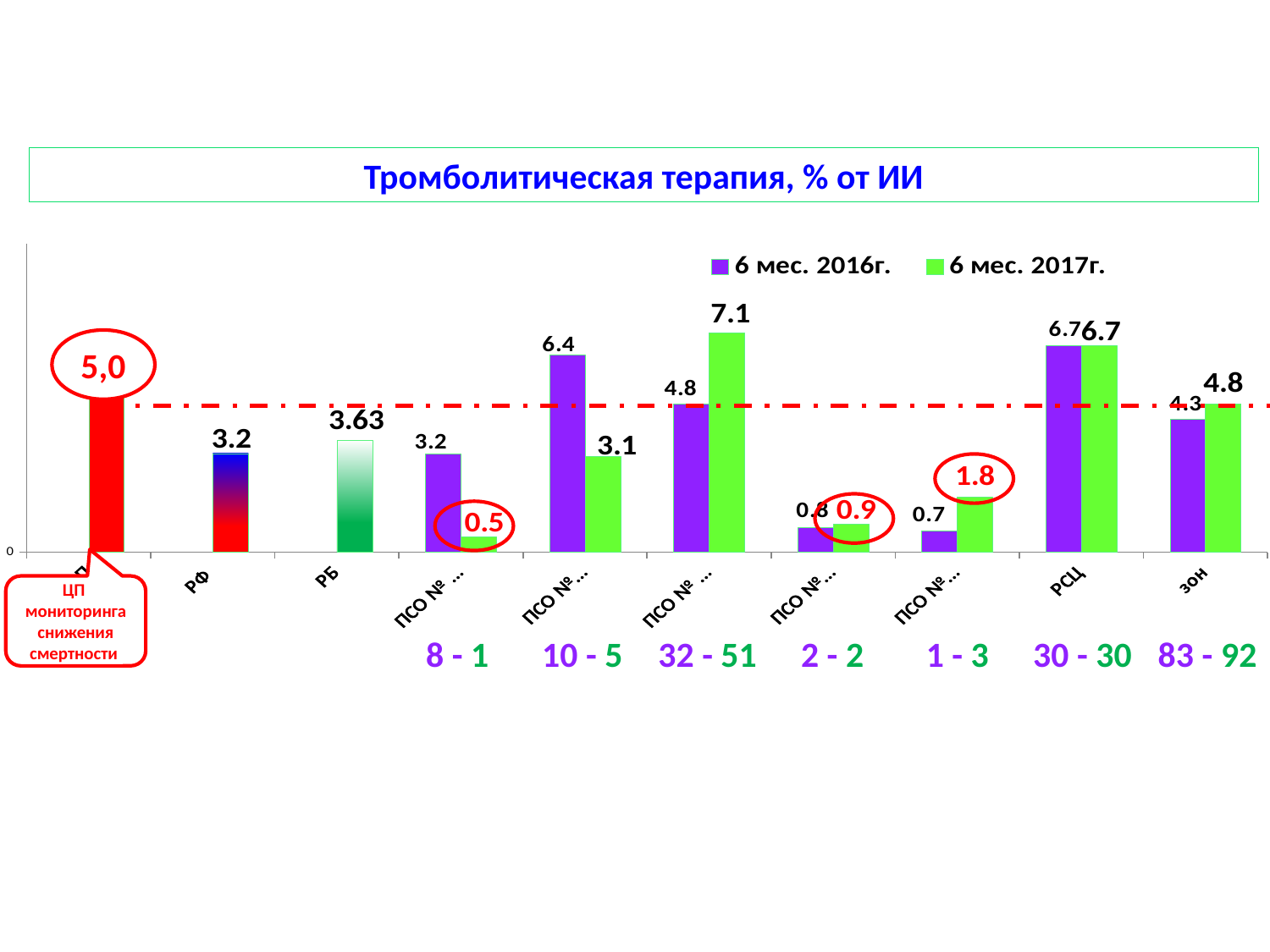
What is the value shown for РФ? 3.2 What is the highest value shown for the 6 мес. 2017г. series? 7.1 Which has the larger 6 мес. 2017г. value, РСЦ or зон? РСЦ What is the difference between the 6 мес. 2017г. and 6 мес. 2016г. values for зон? 0.5 What is the title of the chart? Тромболитическая терапия, % от ИИ What value is circled in red above the red bar at the left of the chart? 5,0 What is the value for зон in 6 мес. 2016г.? 4.3 What kind of chart is shown on the slide? bar chart What is the value for РСЦ in 6 мес. 2017г.? 6.7 What are the two series named in the legend? 6 мес. 2016г. and 6 мес. 2017г. How many series does the legend list? 2 What is the value shown for РБ? 3.63